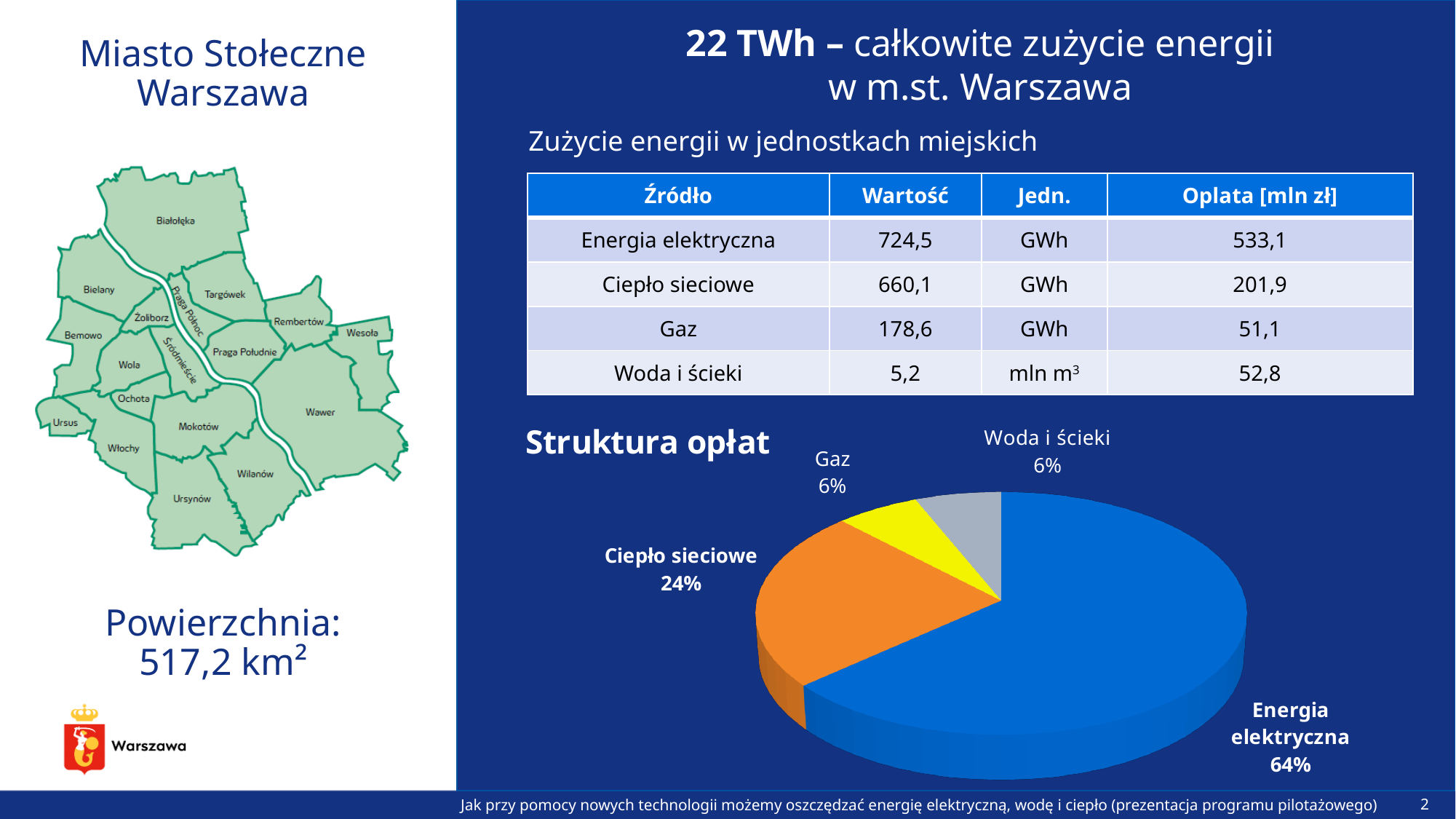
In the "Struktura opłat" pie chart, what is the combined share of Gaz and Woda i ścieki? 12% Which slice is the largest in the "Struktura opłat" pie chart? Energia elektryczna In the "Struktura opłat" pie chart, what share does Woda i ścieki have? 6% What kind of chart is shown under the heading "Struktura opłat"? pie chart What colour is the Energia elektryczna slice in the "Struktura opłat" pie chart? blue What is the title of the pie chart on the slide? Struktura opłat In the "Struktura opłat" pie chart, what is the difference in percentage points between Energia elektryczna and Ciepło sieciowe? 40 percentage points How many slices does the "Struktura opłat" pie chart have? 4 In the "Struktura opłat" pie chart, what share does Gaz have? 6% In the "Struktura opłat" pie chart, what share does Ciepło sieciowe have? 24% In the "Struktura opłat" pie chart, which is larger: Ciepło sieciowe or Gaz? Ciepło sieciowe